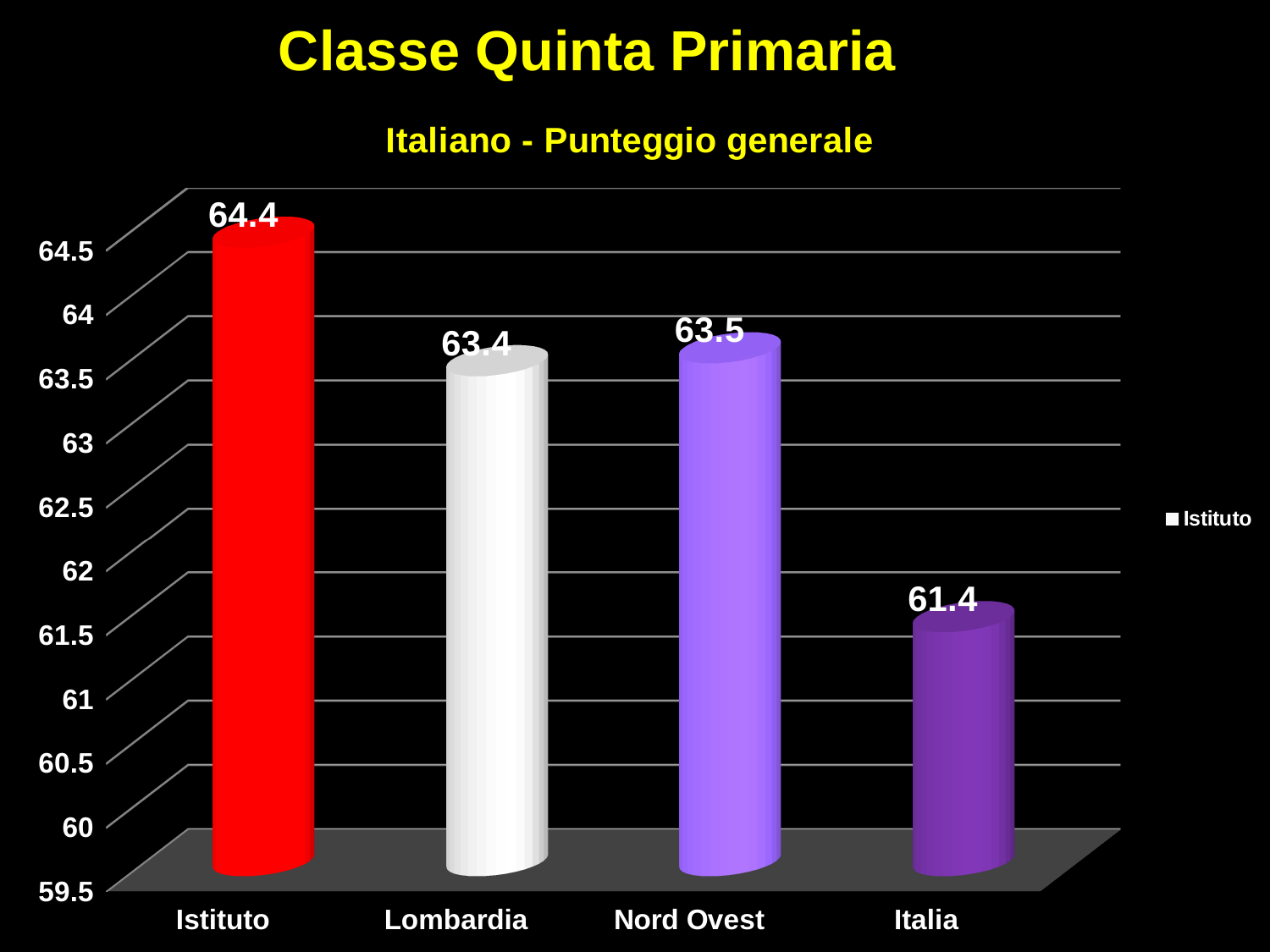
What is the chart's title? Italiano - Punteggio generale What is the difference between the values for Nord Ovest and Lombardia? 0.1 Which is larger, the value for Istituto or the value for Italia? Istituto What is the value for Nord Ovest? 63.5 What is the value for Italia? 61.4 Which category has the highest value? Istituto Which category has the lowest value? Italia What is the difference between the values for Istituto and Italia? 3 What is the value for Istituto? 64.4 What is the value for Lombardia? 63.4 What kind of chart is shown? bar chart How many categories are shown on the x axis? 4